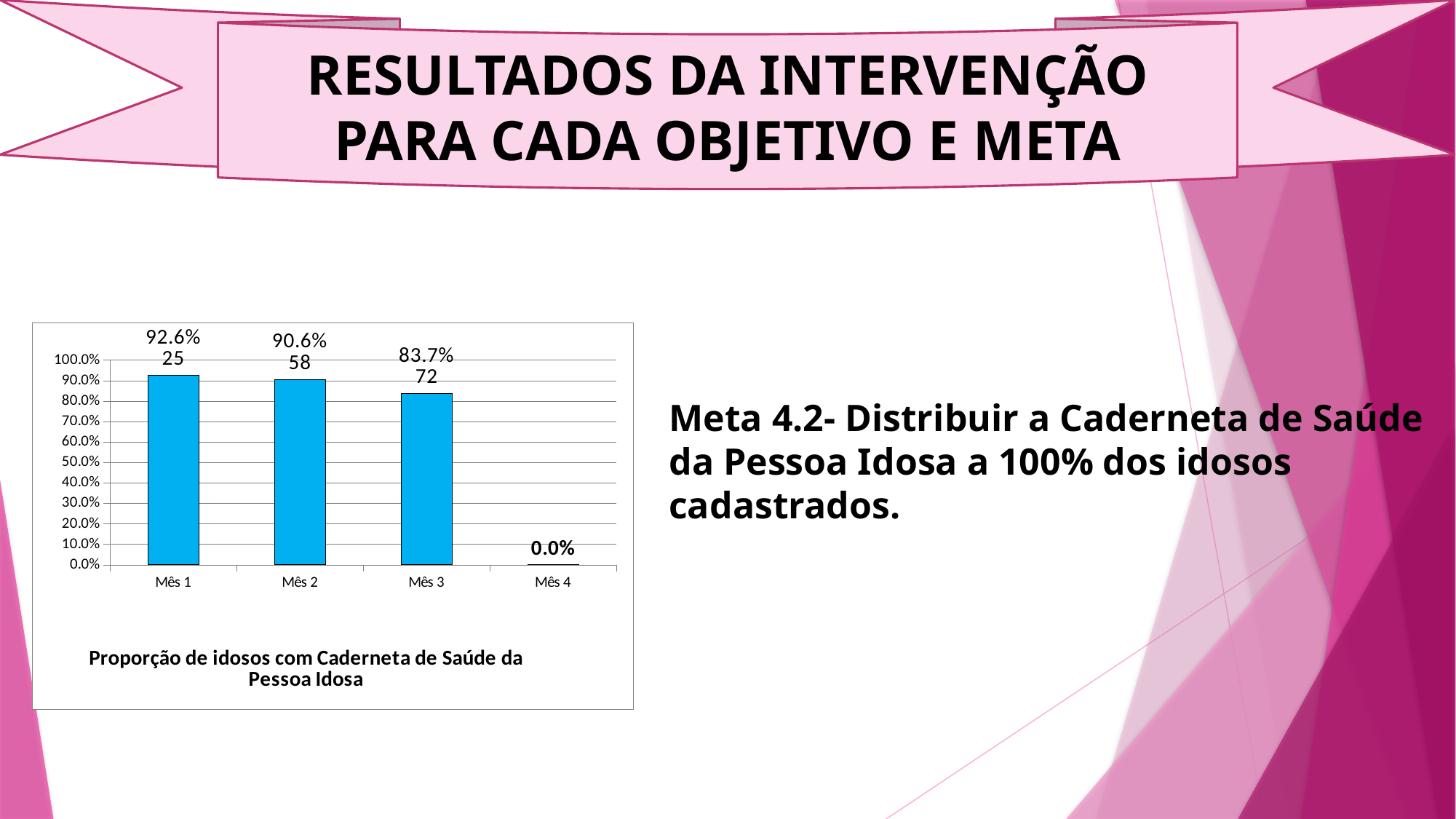
What count is printed above the bar for Mês 2? 58 What kind of chart is shown on the slide? Bar chart What is the percentage value shown for Mês 4? 0.0% What is the percentage value shown for Mês 1? 92.6% What is the difference in percentage points between Mês 1 and Mês 3? 8.9 Do the percentage values rise or fall from Mês 1 to Mês 3? Fall How many months are shown on the x axis? 4 What is the title of the chart? Proporção de idosos com Caderneta de Saúde da Pessoa Idosa Which month has the lowest percentage? Mês 4 Which is larger, the percentage for Mês 2 or for Mês 3? Mês 2 What is the percentage value shown for Mês 3? 83.7% Which month has the highest percentage? Mês 1